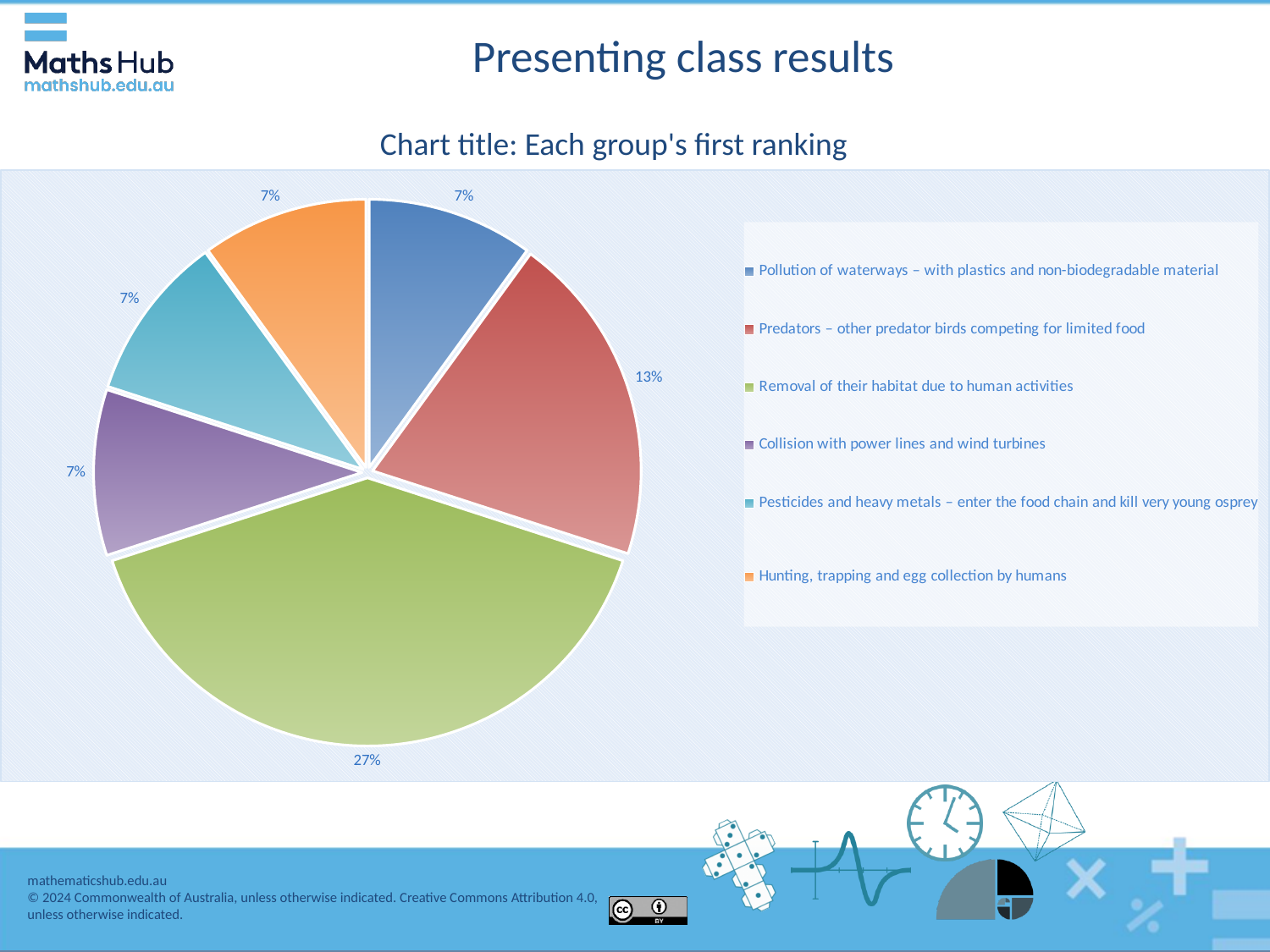
What percentage is shown for 'Hunting, trapping and egg collection by humans'? 7% What percentage is shown for 'Predators – other predator birds competing for limited food'? 13% How many slices are labelled 7%? 4 What percentage is shown for 'Pollution of waterways – with plastics and non-biodegradable material'? 7% How many categories does the legend list? 6 What is the difference in percentage points between the 'Removal of their habitat due to human activities' slice and the 'Predators – other predator birds competing for limited food' slice? 14 Which category has the largest slice of the pie? Removal of their habitat due to human activities What type of chart is shown on the slide? pie chart What is the chart title? Each group's first ranking What percentage is shown for 'Removal of their habitat due to human activities'? 27% What colour is the slice for 'Removal of their habitat due to human activities'? green Which is larger, the slice for 'Predators – other predator birds competing for limited food' or the slice for 'Collision with power lines and wind turbines'? Predators – other predator birds competing for limited food